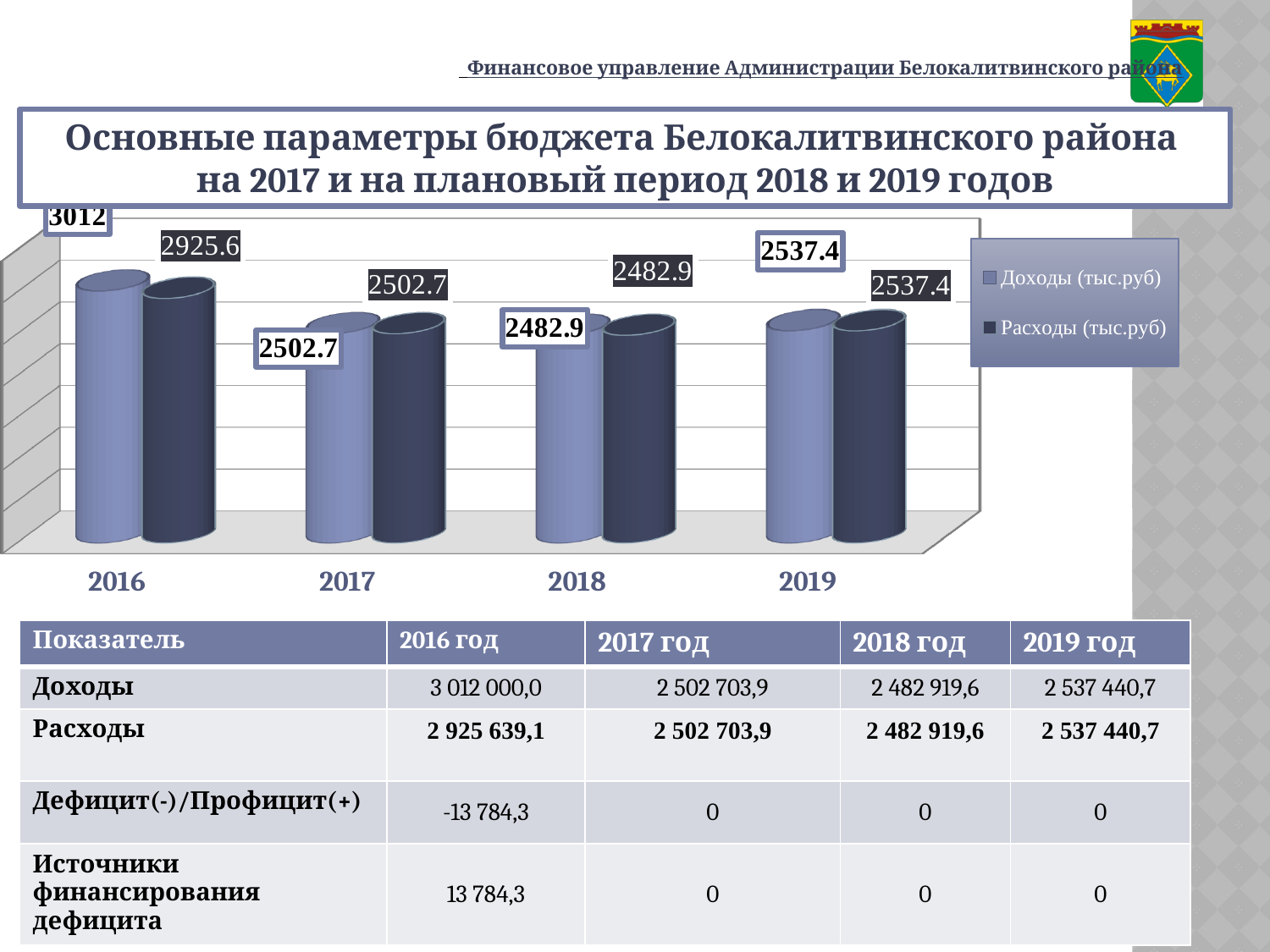
Which is larger in the chart: Доходы for 2017 or Доходы for 2019? Доходы for 2019 In which year is Доходы (тыс.руб) highest in the chart? 2016 What is the value of Доходы (тыс.руб) for 2018 in the chart? 2482.9 What kind of chart is shown on the slide? Bar chart What is the value of Расходы (тыс.руб) for 2019 in the chart? 2537.4 What is the value of Доходы (тыс.руб) for 2016 in the chart? 3012 How many years are shown on the x axis of the chart? 4 How many series does the chart legend list? 2 In which year is Расходы (тыс.руб) lowest in the chart? 2018 What is the difference between Доходы and Расходы for 2016 in the chart? 86.4 What is the value of Расходы (тыс.руб) for 2016 in the chart? 2925.6 From 2016 to 2018, do the Доходы (тыс.руб) values rise or fall? Fall